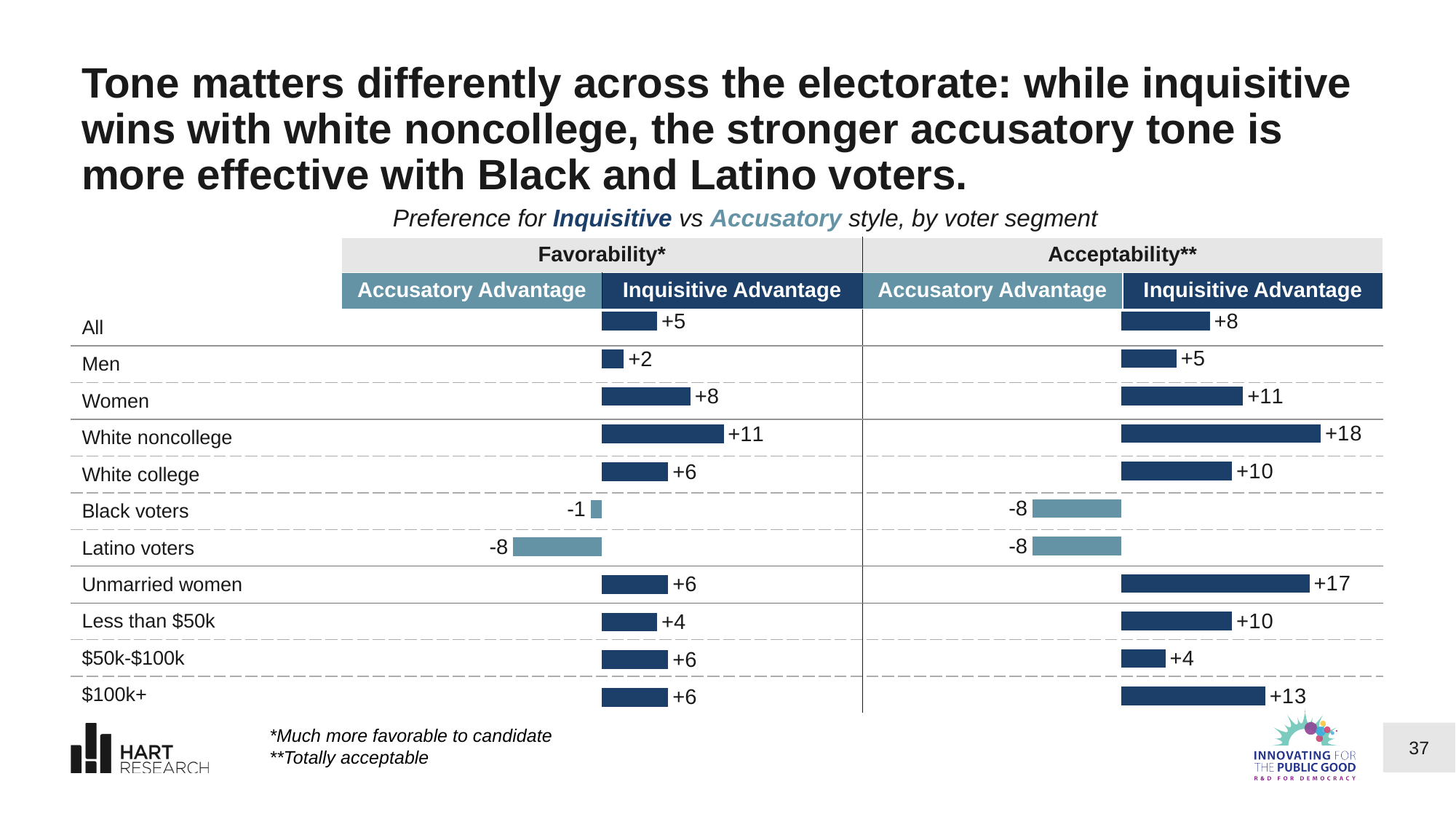
In the Favorability chart, what is the value for Black voters? -1 In the Acceptability chart, what is the value for Unmarried women? +17 In the Favorability chart, which is larger, the value for Women or the value for Men? Women What colour are the bars showing an Accusatory Advantage? light blue In the Acceptability chart, which voter segment has the highest value? White noncollege In the Favorability chart, which voter segment has the lowest value? Latino voters In the Favorability chart, what is the value for White noncollege? +11 What kind of chart is the Acceptability chart? bar chart How many voter segments are shown in the Favorability chart? 11 In the Acceptability chart, what is the difference between the values for Women and Men? 6 In the Favorability chart, what is the value for Latino voters? -8 In the Acceptability chart, what is the value for $50k-$100k? +4